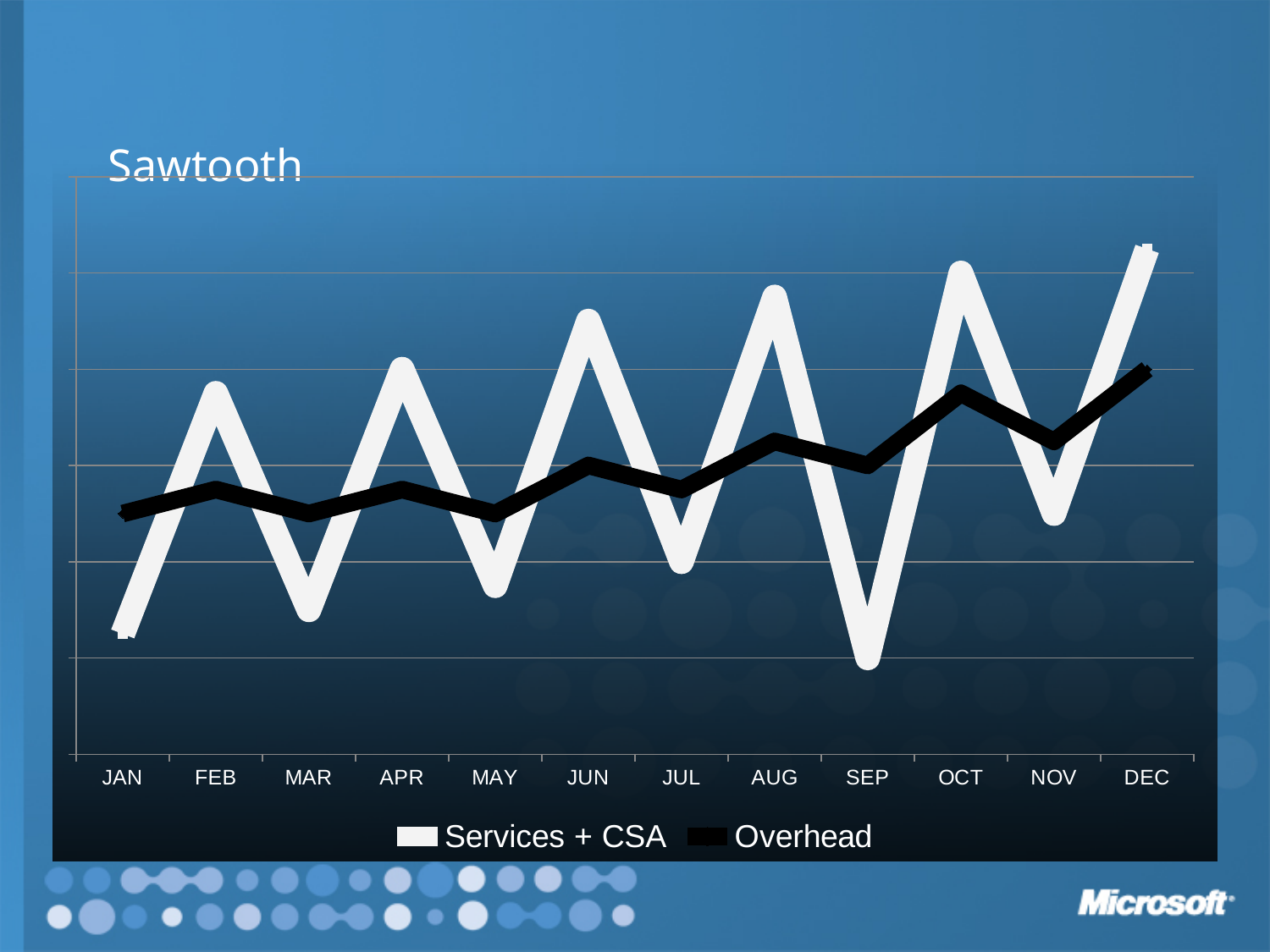
Does the Overhead series generally rise or fall from JAN to DEC? rise In which month does the Services + CSA series reach its highest value? DEC What kind of chart is shown on the slide? line chart Do the peaks of the Services + CSA series rise or fall from FEB to DEC? rise In JUN, which series has the higher value, Services + CSA or Overhead? Services + CSA How many months are shown on the x axis? 12 How many series does the legend list? 2 Which two series are listed in the legend? Services + CSA and Overhead What is the title of the chart? Sawtooth In which month does the Overhead series reach its highest value? DEC In which month does the Services + CSA series reach its lowest value? SEP In SEP, which series has the higher value, Services + CSA or Overhead? Overhead